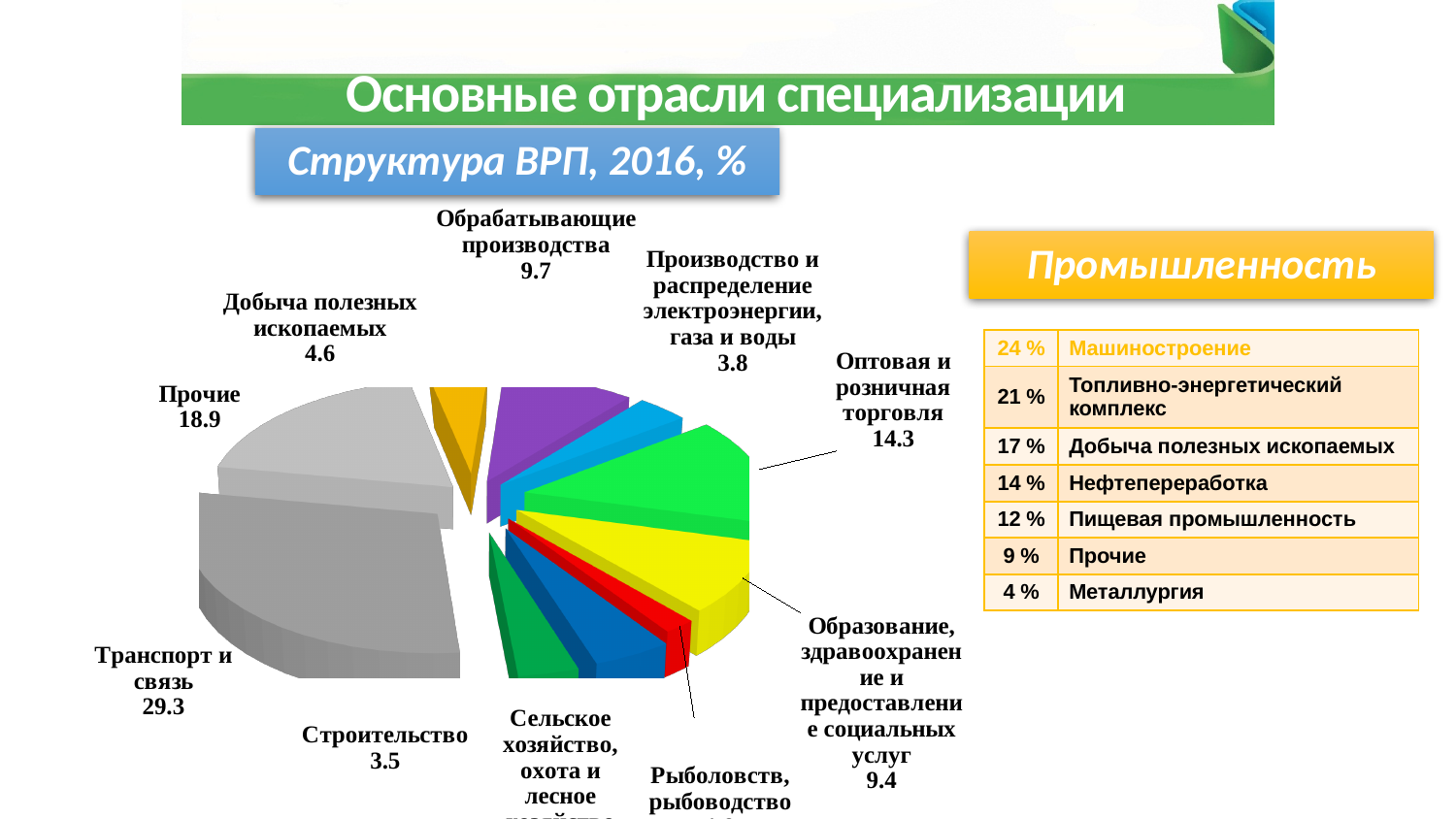
What type of chart is shown on the slide? pie chart What is the value for Транспорт и связь in the pie chart? 29.3 What is the value for Строительство in the pie chart? 3.5 Which is larger in the pie chart: Производство и распределение электроэнергии, газа и воды or Образование, здравоохранение и предоставление социальных услуг? Образование, здравоохранение и предоставление социальных услуг What is the difference between the values for Транспорт и связь and Прочие in the pie chart? 10.4 What is the title of the pie chart? Структура ВРП, 2016, % What is the difference between the values for Оптовая и розничная торговля and Обрабатывающие производства in the pie chart? 4.6 Which category has the largest share in the pie chart? Транспорт и связь What is the value for Добыча полезных ископаемых in the pie chart? 4.6 Which is larger in the pie chart: Прочие or Оптовая и розничная торговля? Прочие What is the value for Оптовая и розничная торговля in the pie chart? 14.3 What is the value for Обрабатывающие производства in the pie chart? 9.7